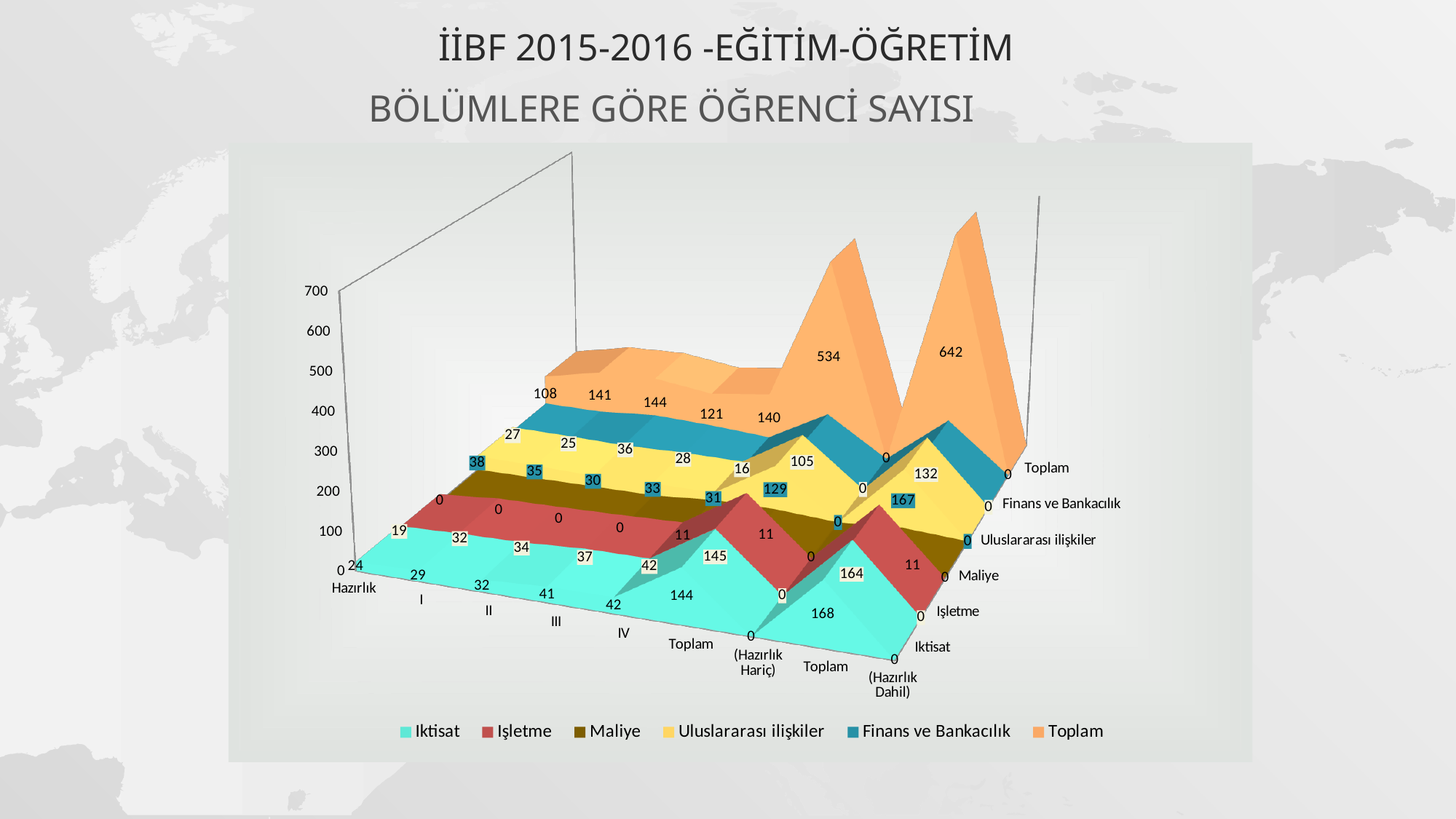
What is the Toplam value for the Toplam (Hazırlık Hariç) category? 534 What is the Finans ve Bankacılık value for Toplam (Hazırlık Hariç)? 105 How many categories are shown along the x axis? 7 Which department series has the lowest value at Toplam (Hazırlık Dahil)? Maliye How many series does the legend list? 6 What is the Uluslararası ilişkiler value for Hazırlık? 38 What is the difference between the Iktisat values for Toplam (Hazırlık Dahil) and Toplam (Hazırlık Hariç)? 24 What is the difference between the Toplam values for Toplam (Hazırlık Dahil) and Toplam (Hazırlık Hariç)? 108 What is the Iktisat value for Toplam (Hazırlık Dahil)? 168 What is the Toplam value for the Toplam (Hazırlık Dahil) category? 642 At Toplam (Hazırlık Dahil), which is larger: Işletme or Finans ve Bankacılık? Işletme What kind of chart is shown on the slide? area chart